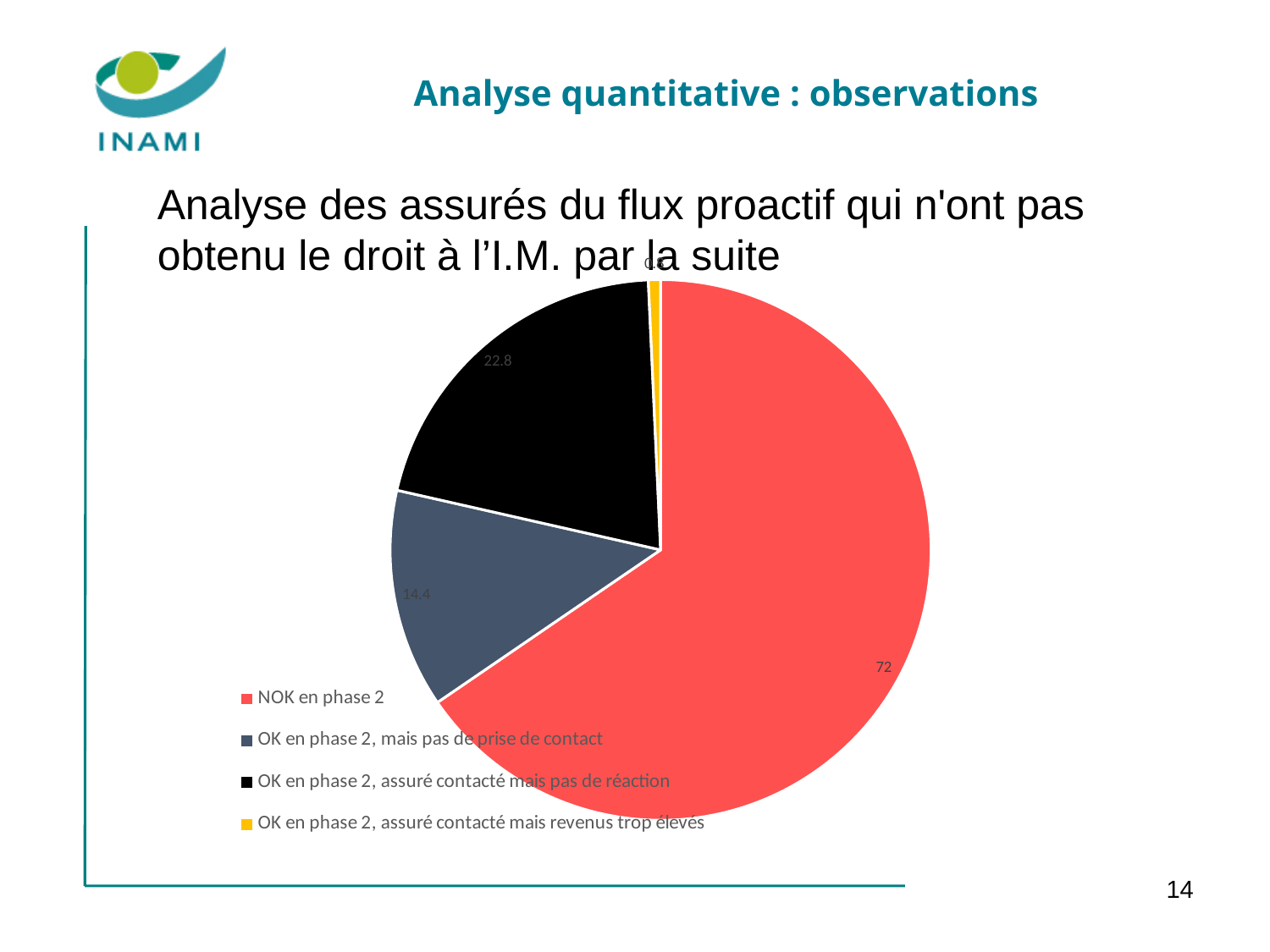
Which slice is larger: 'OK en phase 2, mais pas de prise de contact' or 'OK en phase 2, assuré contacté mais pas de réaction'? OK en phase 2, assuré contacté mais pas de réaction What kind of chart is shown on the slide? Pie chart What is the difference between the values for 'OK en phase 2, assuré contacté mais pas de réaction' and 'OK en phase 2, mais pas de prise de contact'? 8.4 How many entries does the legend of the pie chart list? 4 What is the value shown for the slice 'NOK en phase 2'? 72 What is the difference between the values for 'NOK en phase 2' and 'OK en phase 2, assuré contacté mais pas de réaction'? 49.2 What colour is the slice for 'NOK en phase 2' in the pie chart? Red Which category has the smallest slice in the pie chart? OK en phase 2, assuré contacté mais revenus trop élevés How many slices does the pie chart have? 4 Which category has the largest slice in the pie chart? NOK en phase 2 What is the value shown for the slice 'OK en phase 2, assuré contacté mais pas de réaction'? 22.8 What is the value shown for the slice 'OK en phase 2, mais pas de prise de contact'? 14.4